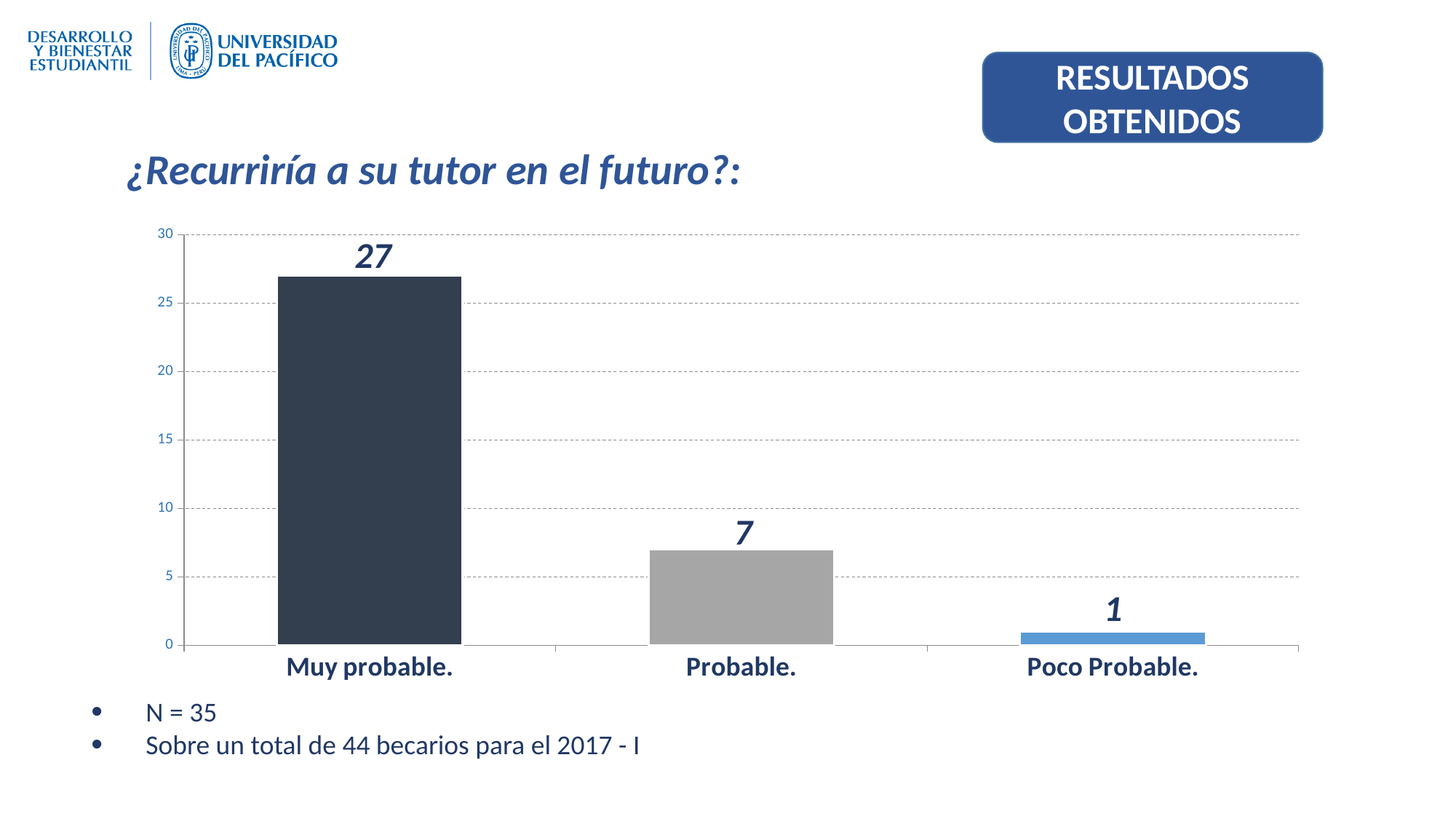
Which category has the lowest value? Poco Probable. Do the values rise or fall from left to right along the x axis? fall What kind of chart is shown on the slide? bar chart Which is larger, the value for "Probable." or the value for "Poco Probable."? Probable. What is the value for "Muy probable."? 27 Which category has the highest value? Muy probable. What is the value for "Probable."? 7 What is the difference between the values for "Probable." and "Poco Probable."? 6 What is the value for "Poco Probable."? 1 What is the difference between the values for "Muy probable." and "Probable."? 20 Is the value for "Muy probable." greater or less than 25? greater How many categories are shown on the x axis? 3